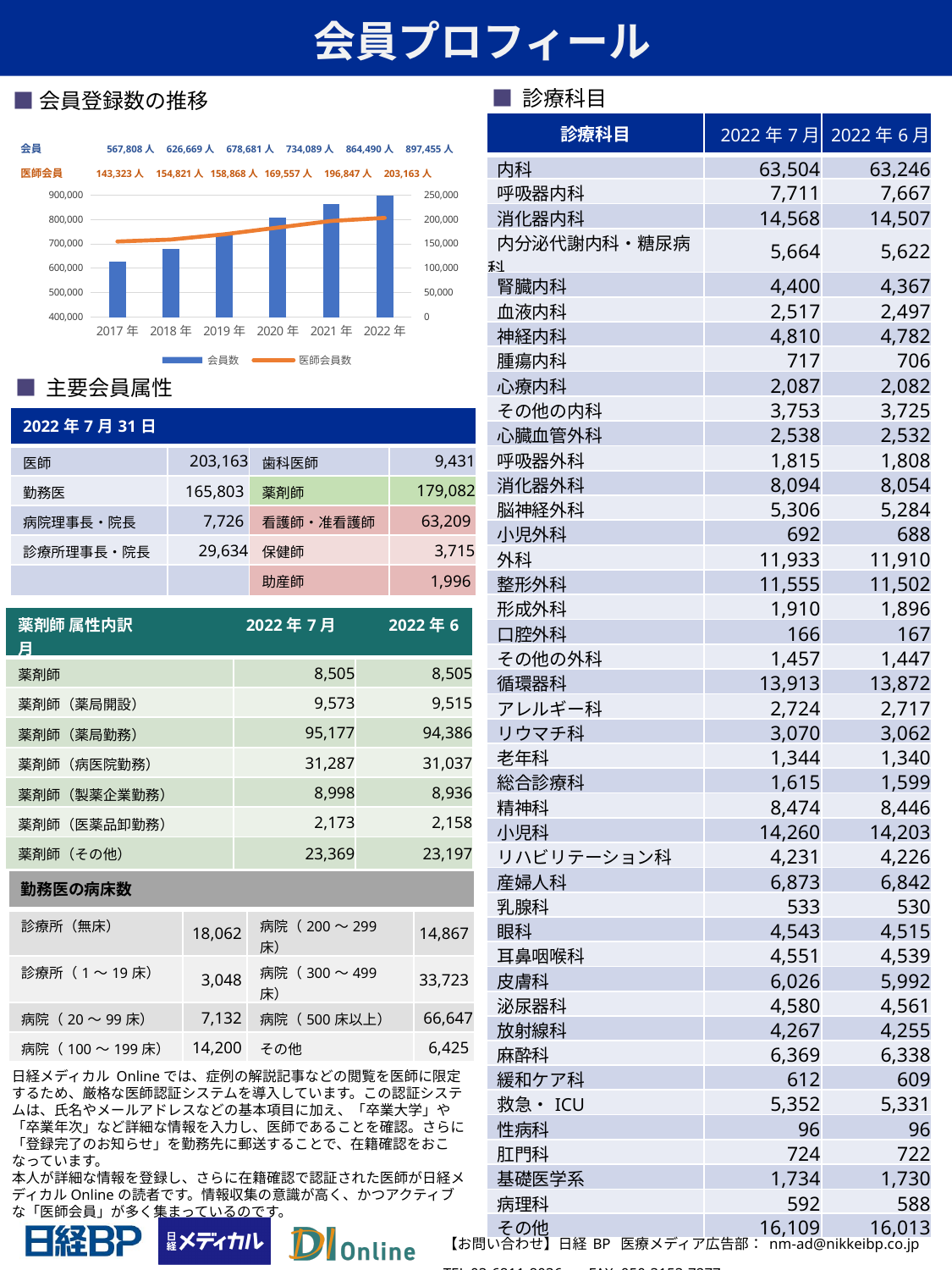
How many years are shown on the x axis of the 会員登録数の推移 chart? 6 In the 会員登録数の推移 chart, which year has the larger 会員数, 2020年 or 2021年? 2021年 In the 会員登録数の推移 chart, what is the 会員 value for 2022年? 897,455人 In the 会員登録数の推移 chart, is the 会員数 bar for 2019年 greater or less than 700,000? greater Do the 会員数 values in the 会員登録数の推移 chart rise or fall from 2017年 to 2022年? rise In the 会員登録数の推移 chart, which year has the highest 会員数? 2022年 In the 会員登録数の推移 chart, which year has the lowest 医師会員数? 2017年 How many series does the legend of the 会員登録数の推移 chart list? 2